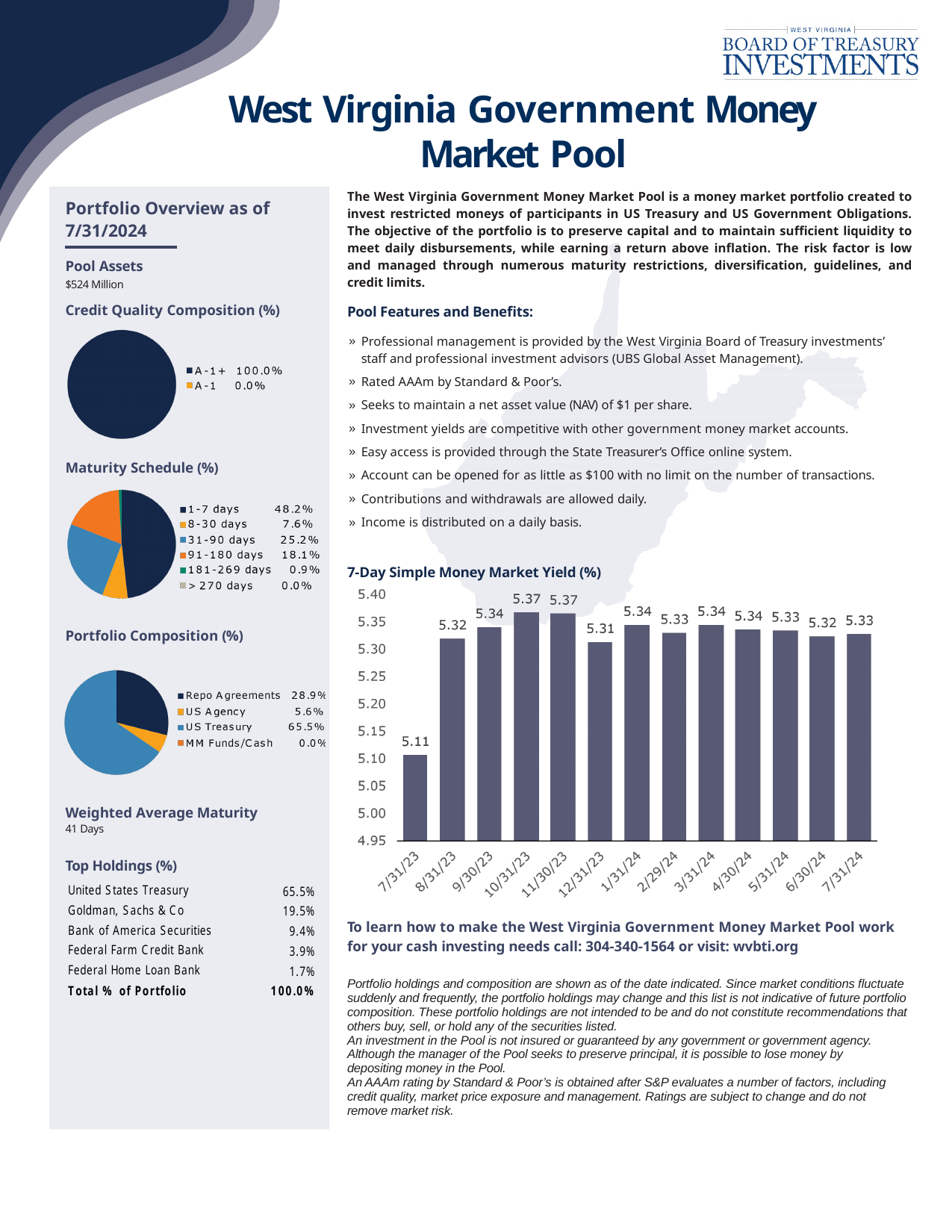
In the 7-Day Simple Money Market Yield (%) chart, what is the value for 7/31/23? 5.11 In the 7-Day Simple Money Market Yield (%) chart, what is the value for 12/31/23? 5.31 In the 7-Day Simple Money Market Yield (%) chart, which date has the lowest yield? 7/31/23 In the 7-Day Simple Money Market Yield (%) chart, what is the difference between the values for 10/31/23 and 7/31/23? 0.26 In the Maturity Schedule (%) pie chart, what share is 31-90 days? 25.2% In the 7-Day Simple Money Market Yield (%) chart, which is larger, the value for 8/31/23 or the value for 7/31/23? 8/31/23 How many bars are plotted in the 7-Day Simple Money Market Yield (%) chart? 13 What kind of chart is the 7-Day Simple Money Market Yield (%) chart? bar chart In the Maturity Schedule (%) pie chart, which category has the largest share? 1-7 days How many entries does the legend of the Credit Quality Composition (%) pie chart list? 2 In the Portfolio Composition (%) pie chart, what share is Repo Agreements? 28.9% In the Portfolio Composition (%) pie chart, what is the difference between the US Treasury share and the US Agency share? 59.9%